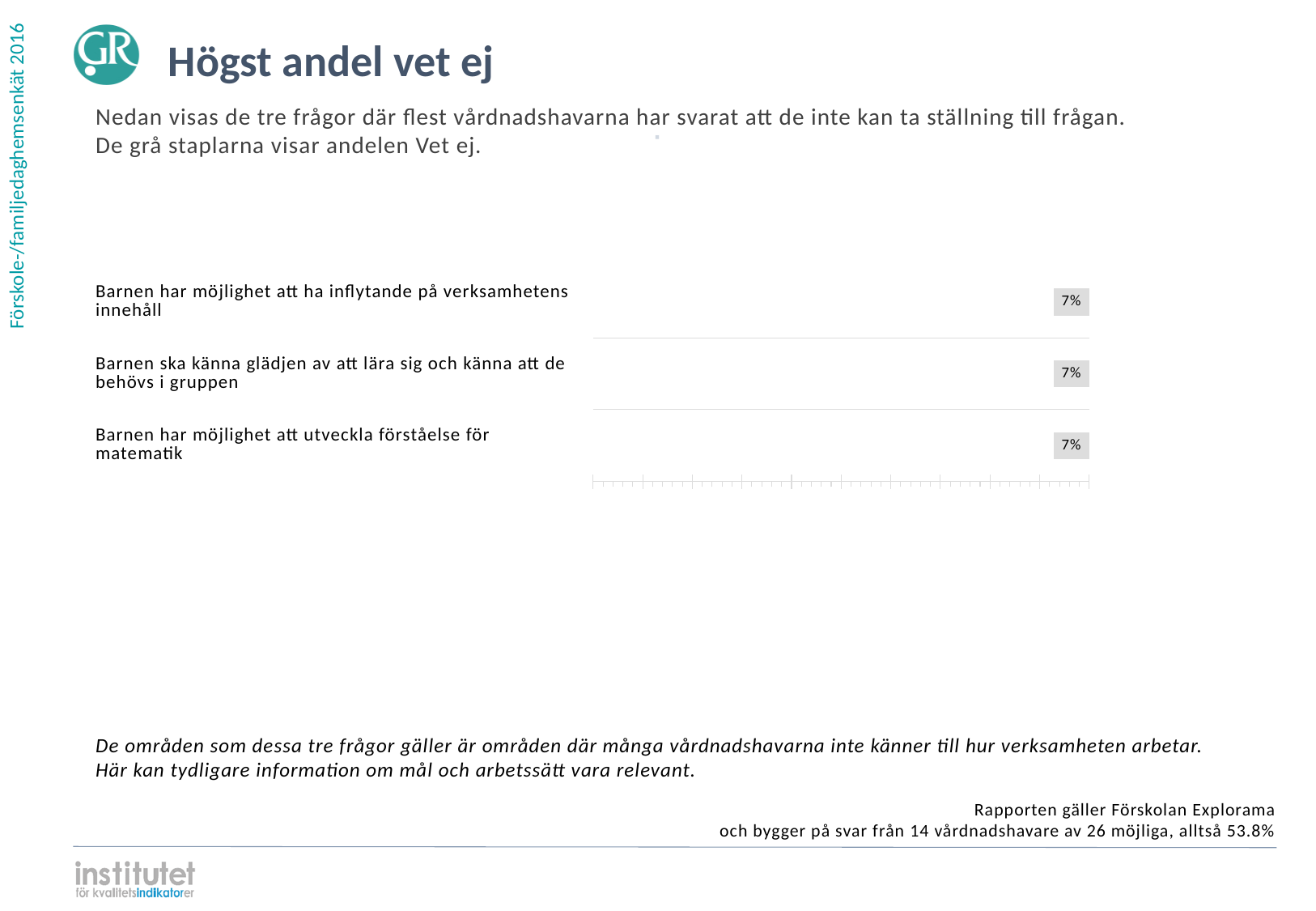
What is the value for "Barnen ska känna glädjen av att lära sig och känna att de behövs i gruppen"? 7% What kind of chart is shown on the slide? bar chart What is the difference between the value for "Barnen har möjlighet att ha inflytande på verksamhetens innehåll" and the value for "Barnen har möjlighet att utveckla förståelse för matematik"? 0% What is the value for "Barnen har möjlighet att utveckla förståelse för matematik"? 7% How many categories are shown in the chart? 3 What is the title of the slide containing the chart? Högst andel vet ej What is the difference between the value for "Barnen ska känna glädjen av att lära sig och känna att de behövs i gruppen" and the value for "Barnen har möjlighet att utveckla förståelse för matematik"? 0% Do all three categories in the chart have the same value? Yes What is the value for "Barnen har möjlighet att ha inflytande på verksamhetens innehåll"? 7% According to the slide text, what do the grey bars show? Andelen Vet ej